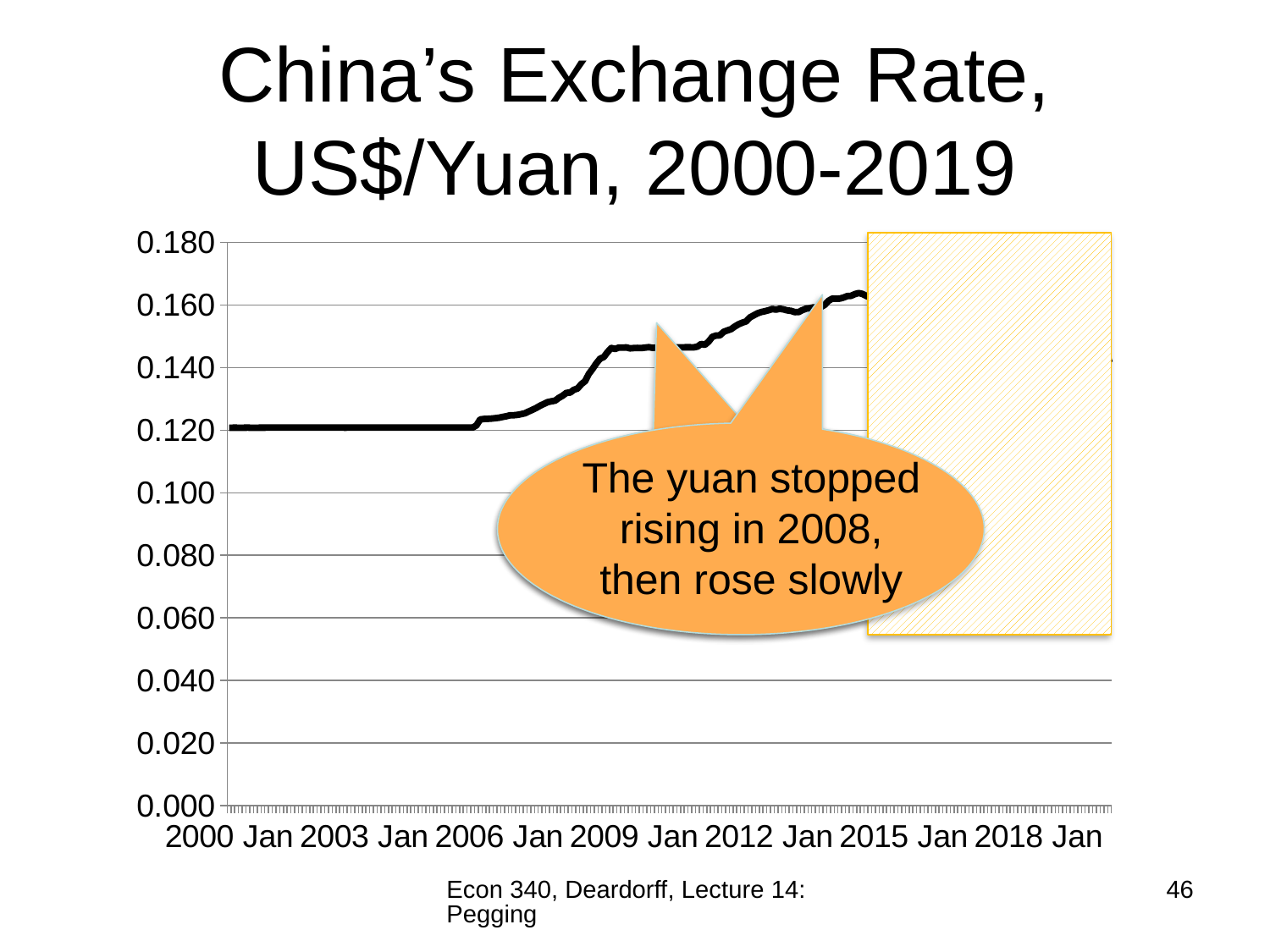
How many year labels are shown on the horizontal axis? 7 Is the exchange rate in 2015 Jan larger or smaller than in 2003 Jan? larger Is the exchange rate in 2012 Jan greater or less than 0.140? greater What kind of chart is shown on the slide? line chart Is the exchange rate in 2006 Jan greater or less than 0.160? less Is the exchange rate in 2015 Jan greater or less than 0.140? greater What is the title of the chart? China's Exchange Rate, US$/Yuan, 2000-2019 Does the exchange rate rise or fall between 2006 Jan and 2009 Jan? rise What is the highest value shown on the vertical axis? 0.180